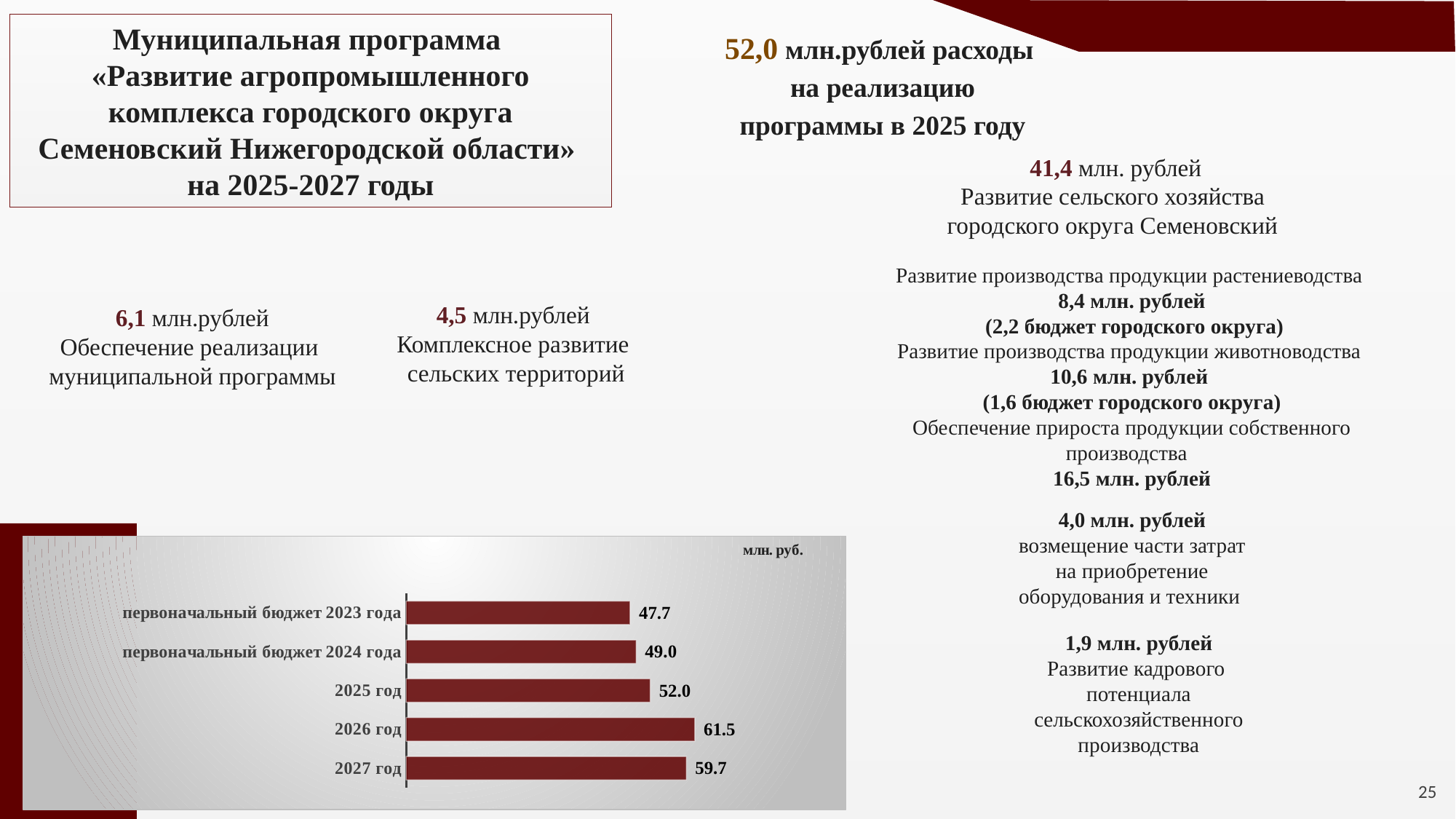
How many categories (bars) does the chart show? 5 What is the difference between the values for "2026 год" and "2025 год"? 9.5 What is the value for "2027 год"? 59.7 Which category has the lowest value? первоначальный бюджет 2023 года What is the value for "первоначальный бюджет 2023 года"? 47.7 What unit label is shown in the top right corner of the chart? млн. руб. What is the value for "первоначальный бюджет 2024 года"? 49.0 What type of chart is shown on the slide? bar chart Which category has the highest value? 2026 год What is the value for "2026 год"? 61.5 Which is larger, the value for "2027 год" or the value for "2026 год"? 2026 год What is the value for "2025 год"? 52.0